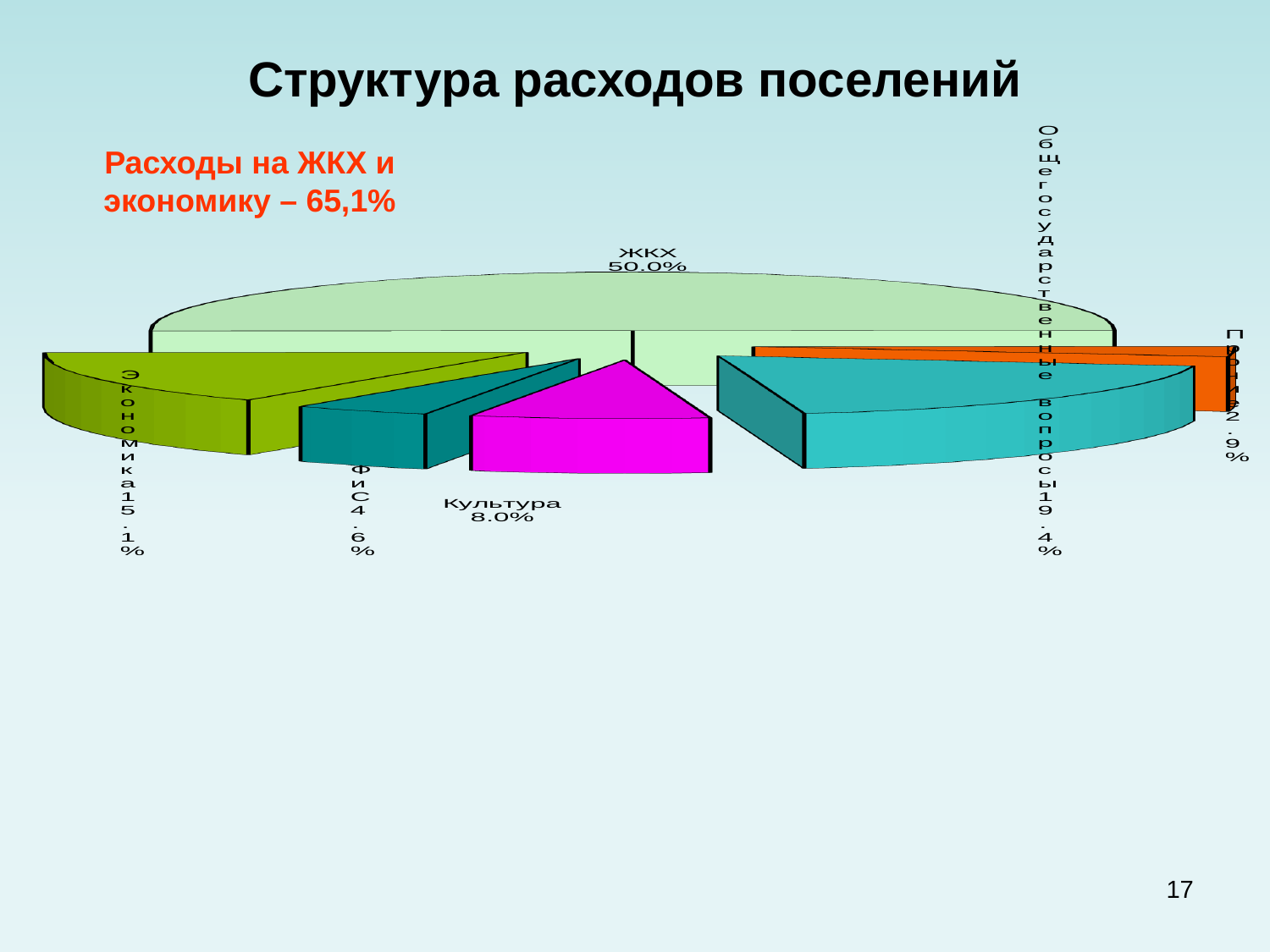
Which is larger, the share for Экономика or the share for Культура? Экономика What share of expenditures do Общегосударственные вопросы account for? 19.4% Which category has the largest share of expenditures? ЖКХ What is the title of the slide's chart? Структура расходов поселений What share of expenditures does ФиС account for? 4.6% What share of expenditures does ЖКХ account for? 50.0% What is the difference between the shares for ЖКХ and Общегосударственные вопросы? 30.6% According to the text on the slide, what is the combined share of expenditures on ЖКХ and экономика? 65,1% What share of expenditures does Культура account for? 8.0% What share of expenditures does Экономика account for? 15.1% What is the difference between the shares for Культура and ФиС? 3.4% What kind of chart is shown on the slide? pie chart